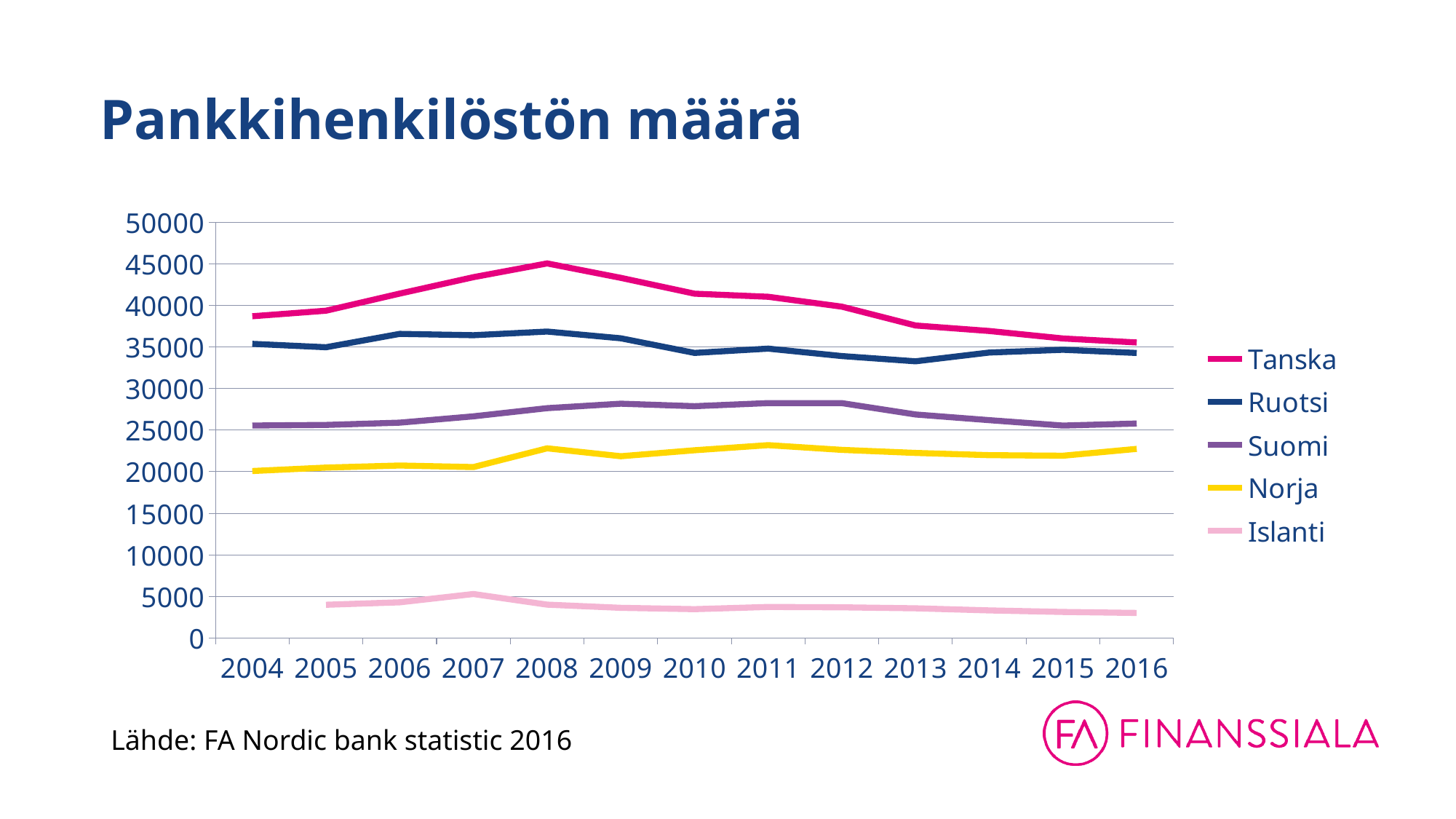
What is the title of the chart? Pankkihenkilöstön määrä Does the value for Tanska rise or fall from 2008 to 2016? fall Which country has the highest number of bank staff in 2008? Tanska Is the value for Islanti in 2016 greater or less than 5000? less What kind of chart is shown on the slide? line chart How many years are shown on the x axis? 13 Which is larger in 2010, the value for Ruotsi or the value for Suomi? Ruotsi How many series does the legend list? 5 In which year does the Tanska line reach its peak? 2008 Is the value for Suomi in 2012 greater or less than 25000? greater Is the value for Tanska in 2008 greater or less than 40000? greater Which country has the lowest number of bank staff throughout the chart? Islanti